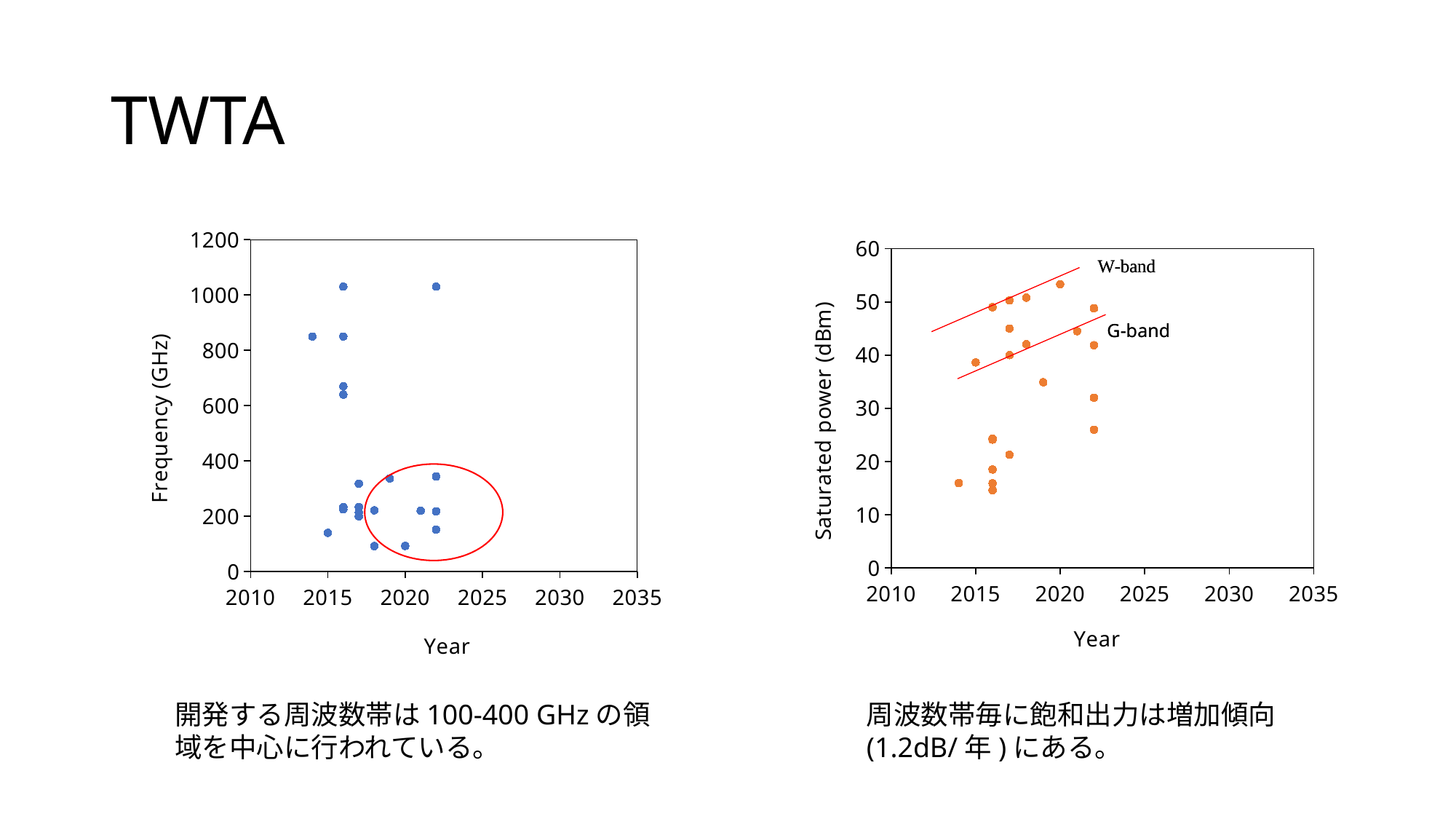
On the right chart, is the value of the point at 2020 greater or less than 50? greater On the right chart, what is the label of the y axis? Saturated power (dBm) On the right chart, do the red W-band and G-band trend lines rise or fall as the year increases? rise On the left chart, is the value of the point at 2014 greater or less than 800? greater What kind of chart is the right chart (Saturated power vs Year)? scatter chart How many charts are shown on the slide? 2 On the right chart, is the value of the point at 2019 greater or less than 40? less On the right chart, in which year is the highest saturated power point plotted? 2020 What kind of chart is the left chart (Frequency vs Year)? scatter chart On the left chart, what is the label of the y axis? Frequency (GHz)